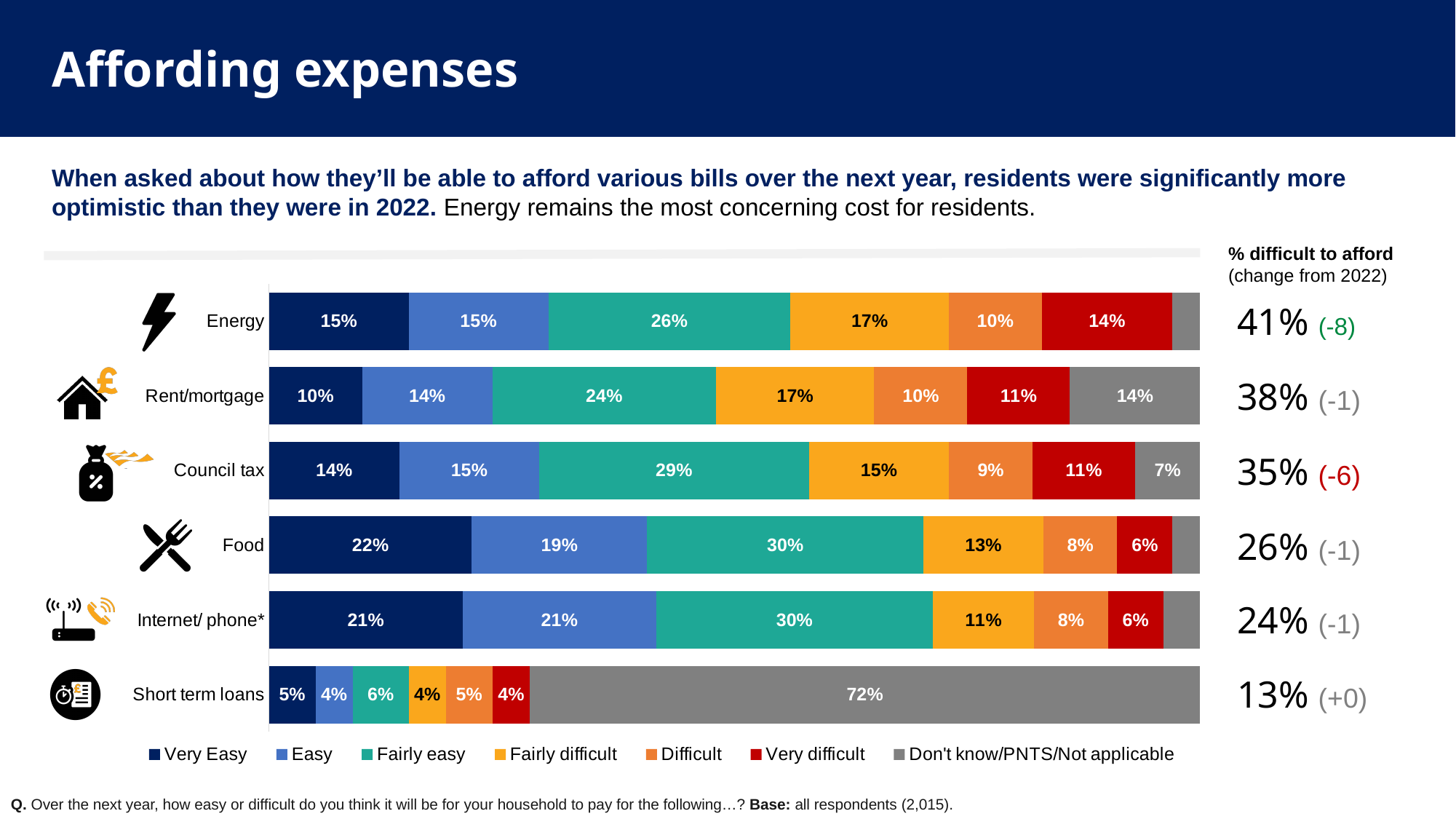
What is the difference between the Fairly difficult percentage for Energy and for Food? 4 percentage points How many expense categories are shown in the chart? 6 What percentage said Council tax would be fairly easy to pay? 29% How many series does the legend list? 7 What kind of chart is shown on the slide? Stacked bar chart What is the % difficult to afford figure shown for Rent/mortgage? 38% What is the Don't know/PNTS/Not applicable value for Short term loans? 72% What percentage of residents said paying for Energy would be very difficult? 14% Which expense has the lowest Fairly easy percentage? Short term loans What is the total of the labelled segments in the Rent/mortgage bar? 100% Which has a larger Easy percentage, Internet/ phone or Rent/mortgage? Internet/ phone Which expense has the highest Very Easy percentage? Food